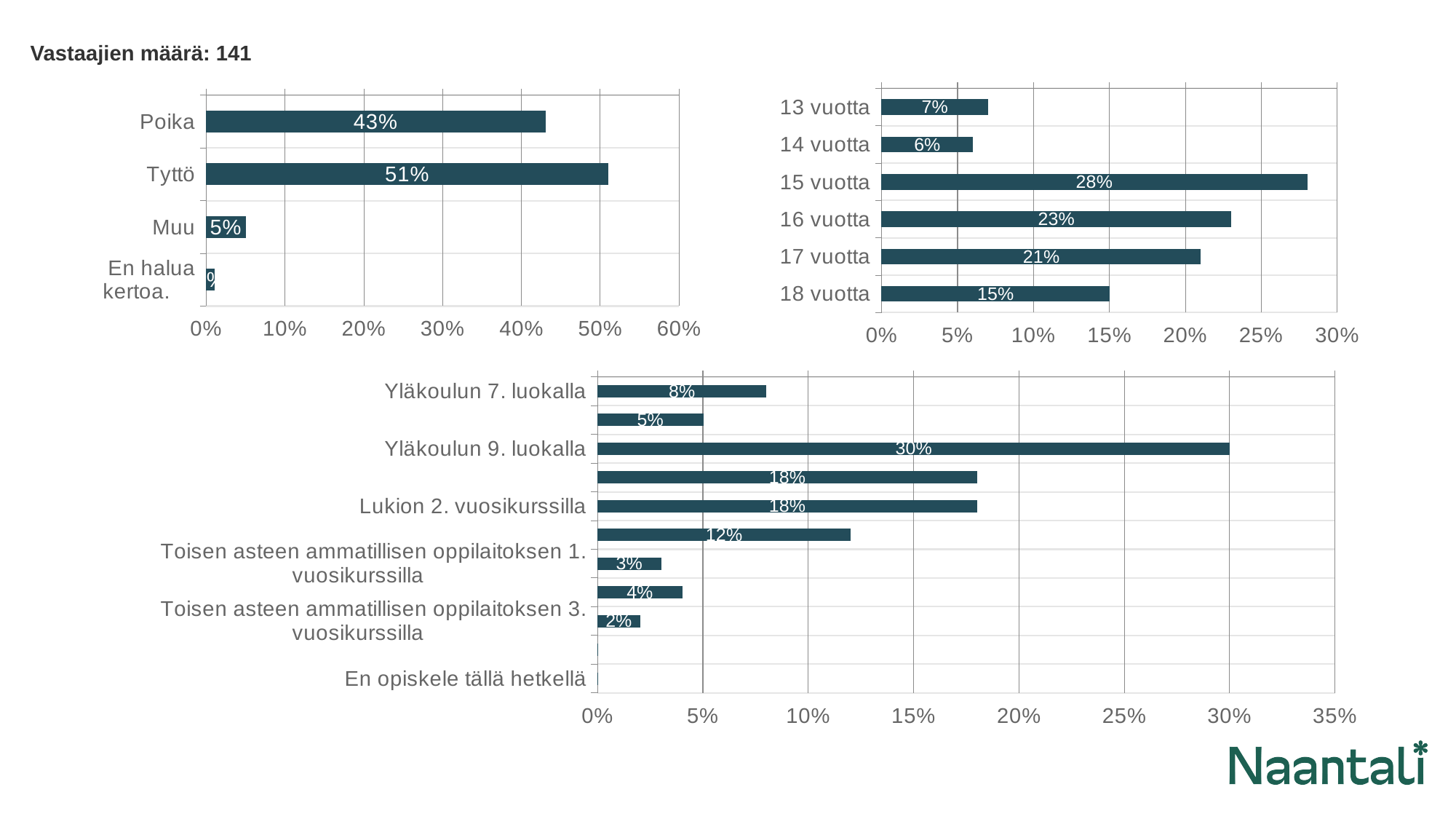
In the top-right chart, which is larger, the value for 16 vuotta or 18 vuotta? 16 vuotta How many age categories are shown in the top-right chart? 6 What kind of chart is the bottom chart? Bar chart In the top-right chart, which age category has the lowest value? 14 vuotta In the top-left chart, what is the difference between the values for Tyttö and Poika? 8% In the top-left chart, what is the value for Poika? 43% In the top-left chart, what is the value for Tyttö? 51% In the bottom chart, what is the value for Lukion 2. vuosikurssilla? 18% In the top-right chart, which age category has the highest value? 15 vuotta In the bottom chart, what is the value for Yläkoulun 9. luokalla? 30% In the top-right chart, what is the value for 17 vuotta? 21% In the top-left chart, which category has the lowest value? En halua kertoa.